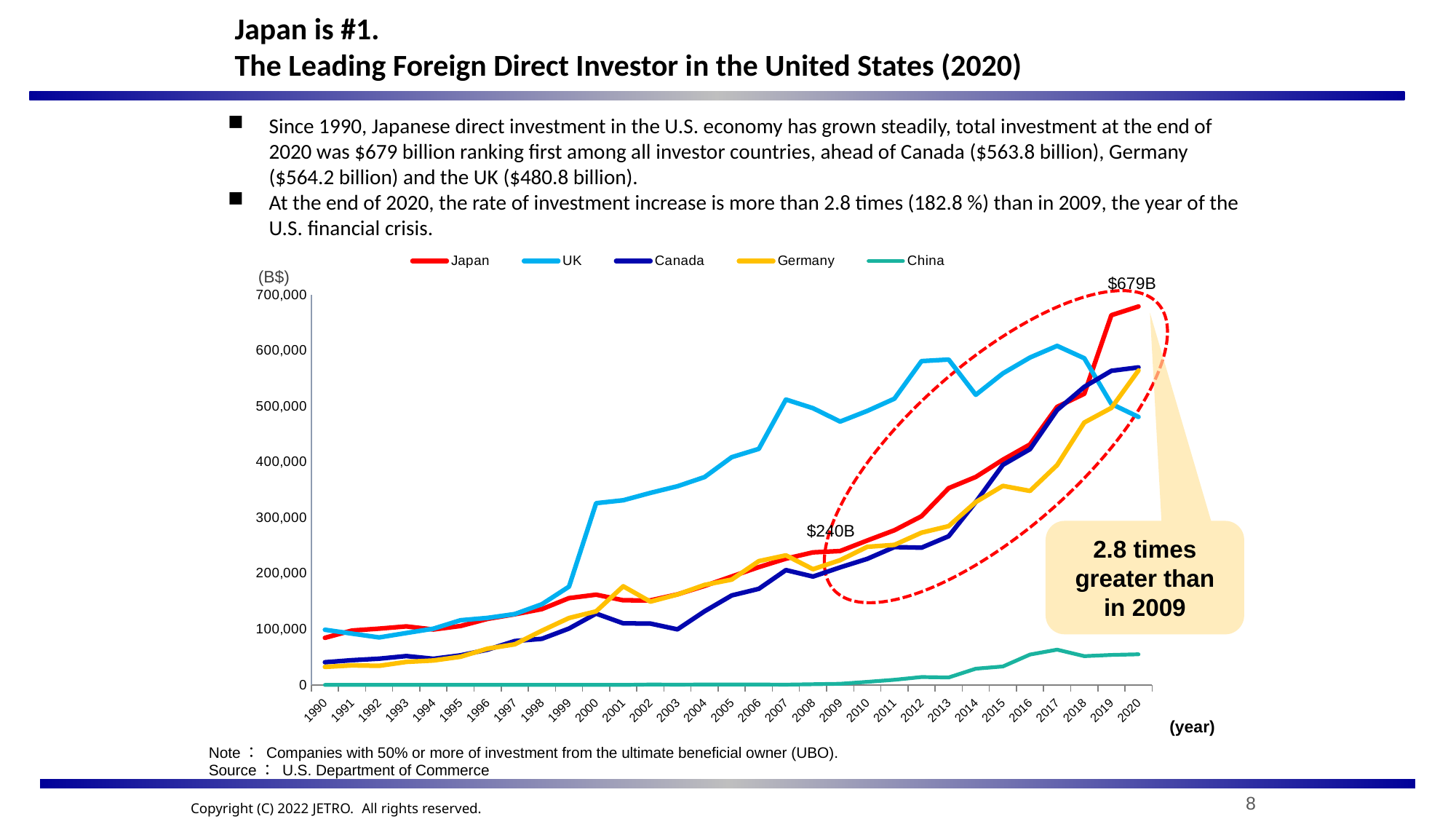
Is the value for China in 2020 greater or less than 100,000? less Which country has the highest value in 2020? Japan What is the labelled value for Japan in 2009? $240B How many years are plotted along the x axis of the chart? 31 Which country's line is the lowest across the chart? China Is the value for the UK in 2000 greater or less than 300,000? greater How many series does the chart legend list? 5 Does the Japan line rise or fall from 1990 to 2020? rises What is the difference between Japan's labelled 2020 value and its labelled 2009 value? $439B What is the labelled value for Japan in 2020? $679B In 2012, which is larger: the value for the UK or the value for Japan? UK What type of chart is shown on the slide? line chart